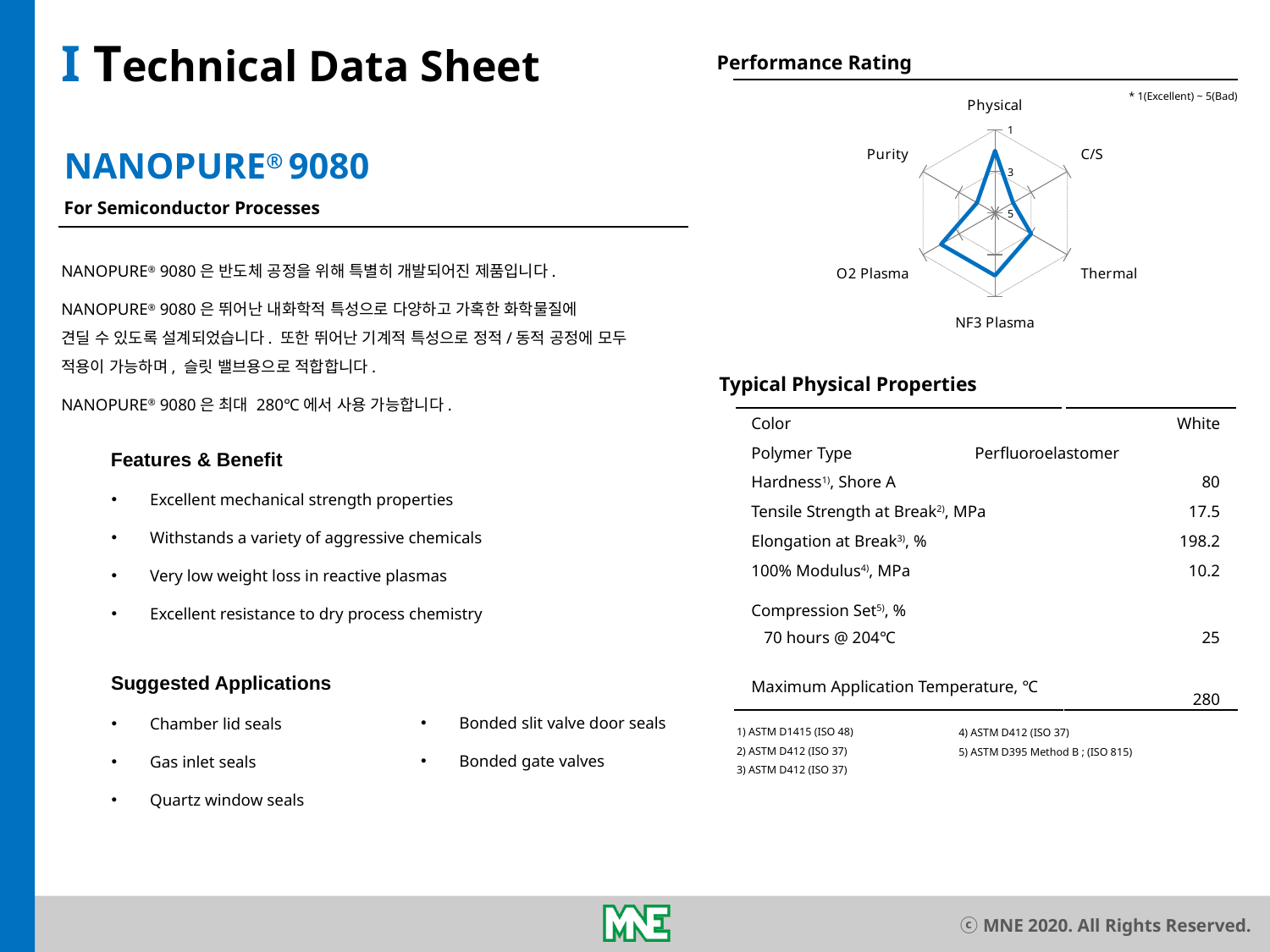
What kind of chart is shown under Performance Rating? Radar chart On the Performance Rating chart, is the value for Physical greater or less than 3? less On the Performance Rating chart, is the value for NF3 Plasma greater or less than 3? less On the Performance Rating chart, is the value for Purity greater or less than 3? greater On the Performance Rating chart, what rating does 1 represent according to the note? Excellent What is the title of the radar chart on the slide? Performance Rating On the Performance Rating chart, which has the worse (higher) rating, Purity or Thermal? Purity On the Performance Rating chart, which has the better (lower) rating, O2 Plasma or C/S? O2 Plasma How many performance categories (axes) does the Performance Rating radar chart have? 6